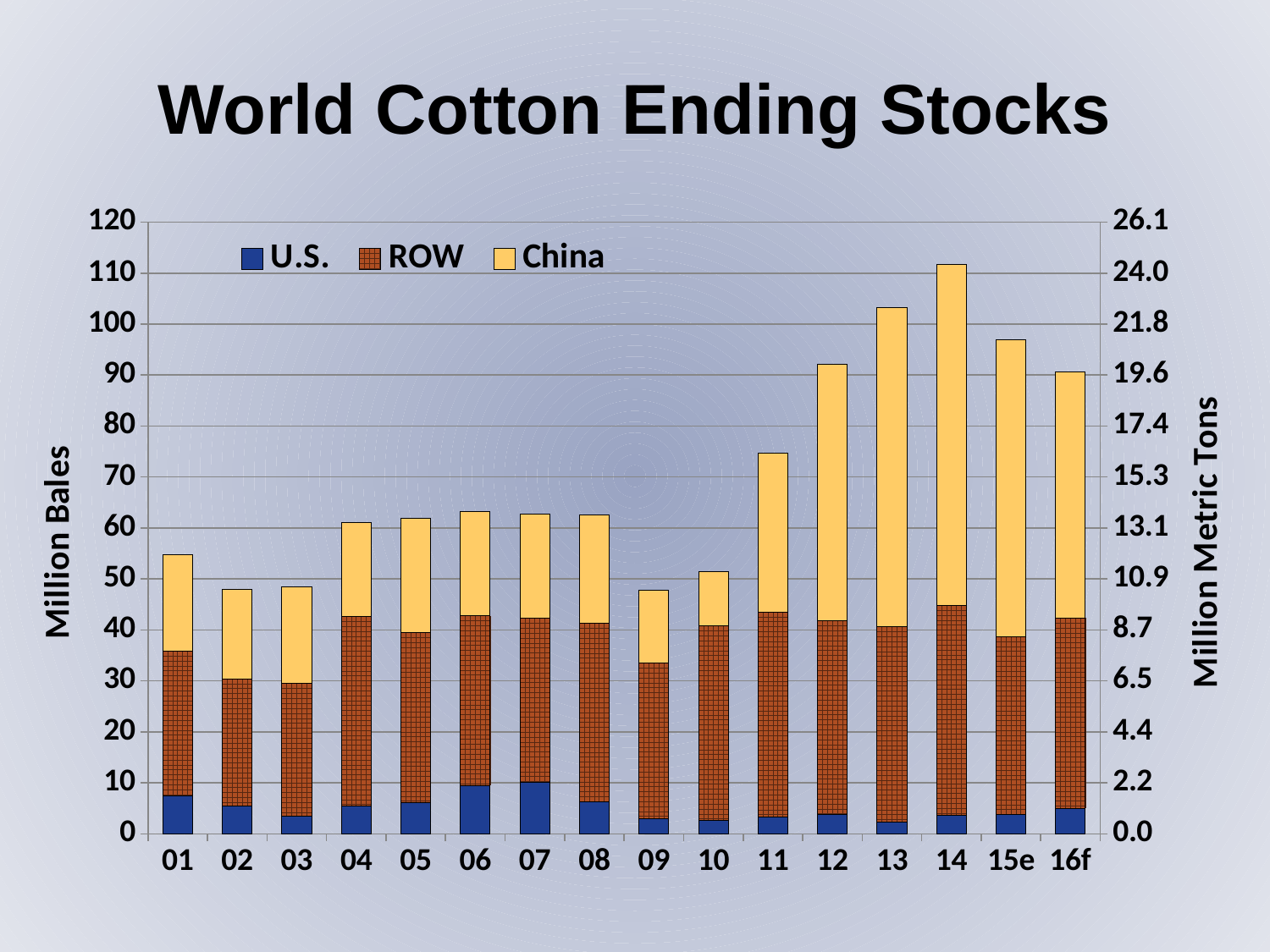
What is the label on the left vertical axis? Million Bales Is the total ending stocks for 14 greater or less than 100 million bales? greater Do total ending stocks rise or fall from 10 to 14? rise Which year has the highest total ending stocks? 14 How many series does the legend list? 3 Which year has the larger total ending stocks, 11 or 12? 12 How many years (bars) are shown along the x axis? 16 What kind of chart is shown on the slide? Stacked bar chart What is the title of the chart? World Cotton Ending Stocks Is the total ending stocks for 10 greater or less than 60 million bales? less Is the total ending stocks for 16f greater or less than 80 million bales? greater